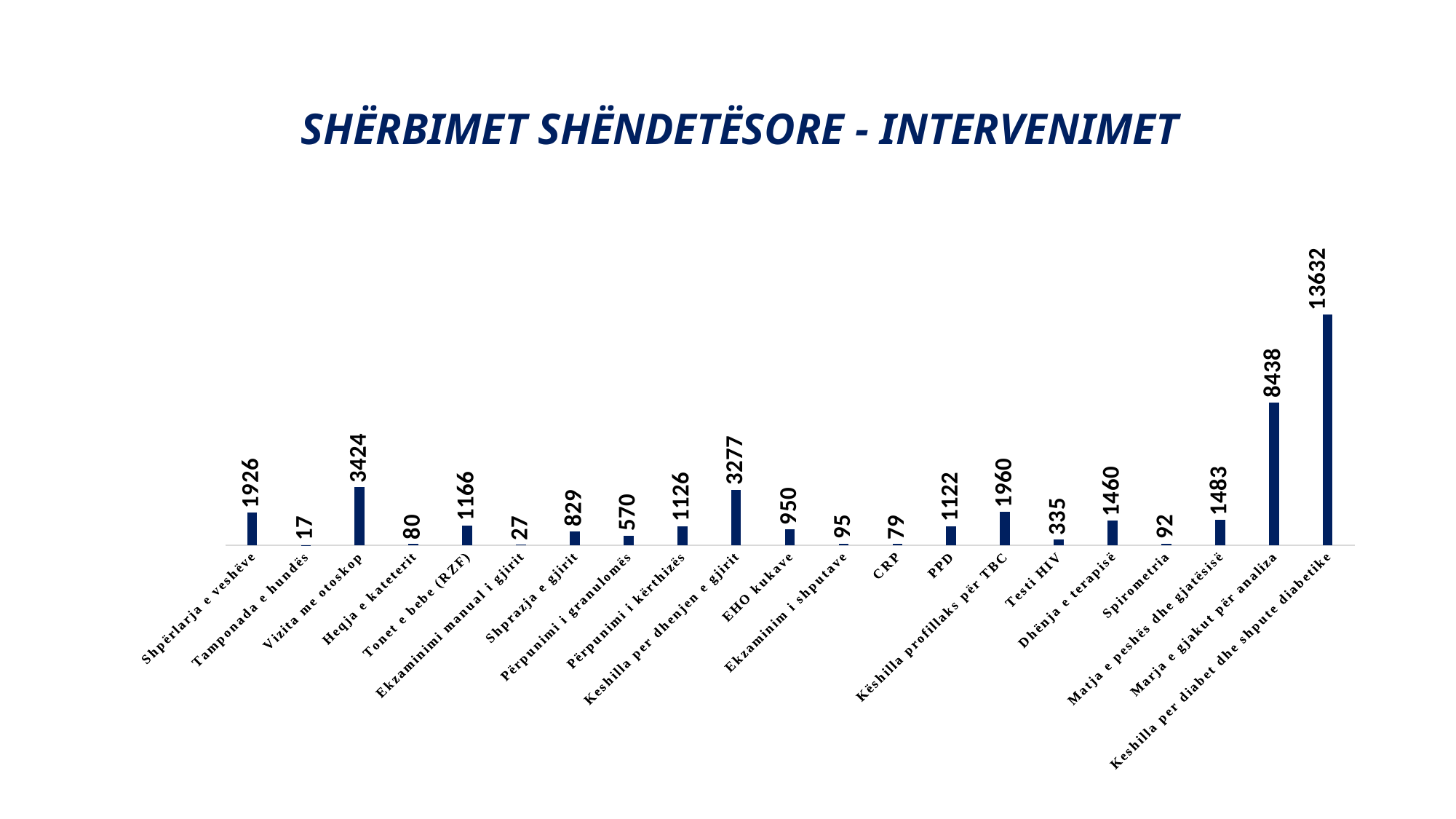
What is the difference between the values for Keshilla per diabet dhe shpute diabetike and Marja e gjakut për analiza? 5194 What type of chart is shown on the slide? Bar chart Which category has the highest value? Keshilla per diabet dhe shpute diabetike Which category has the lowest value? Tamponada e hundës What is the title of the chart? SHËRBIMET SHËNDETËSORE - INTERVENIMET What is the value for Marja e gjakut për analiza? 8438 What is the difference between the values for Këshilla profillaks për TBC and Shpërlarja e veshëve? 34 What is the value for Vizita me otoskop? 3424 What is the value for Testi HIV? 335 How many categories are plotted in the chart? 21 What is the value for Spirometria? 92 Which is larger, the value for Vizita me otoskop or the value for Keshilla per dhenjen e gjirit? Vizita me otoskop